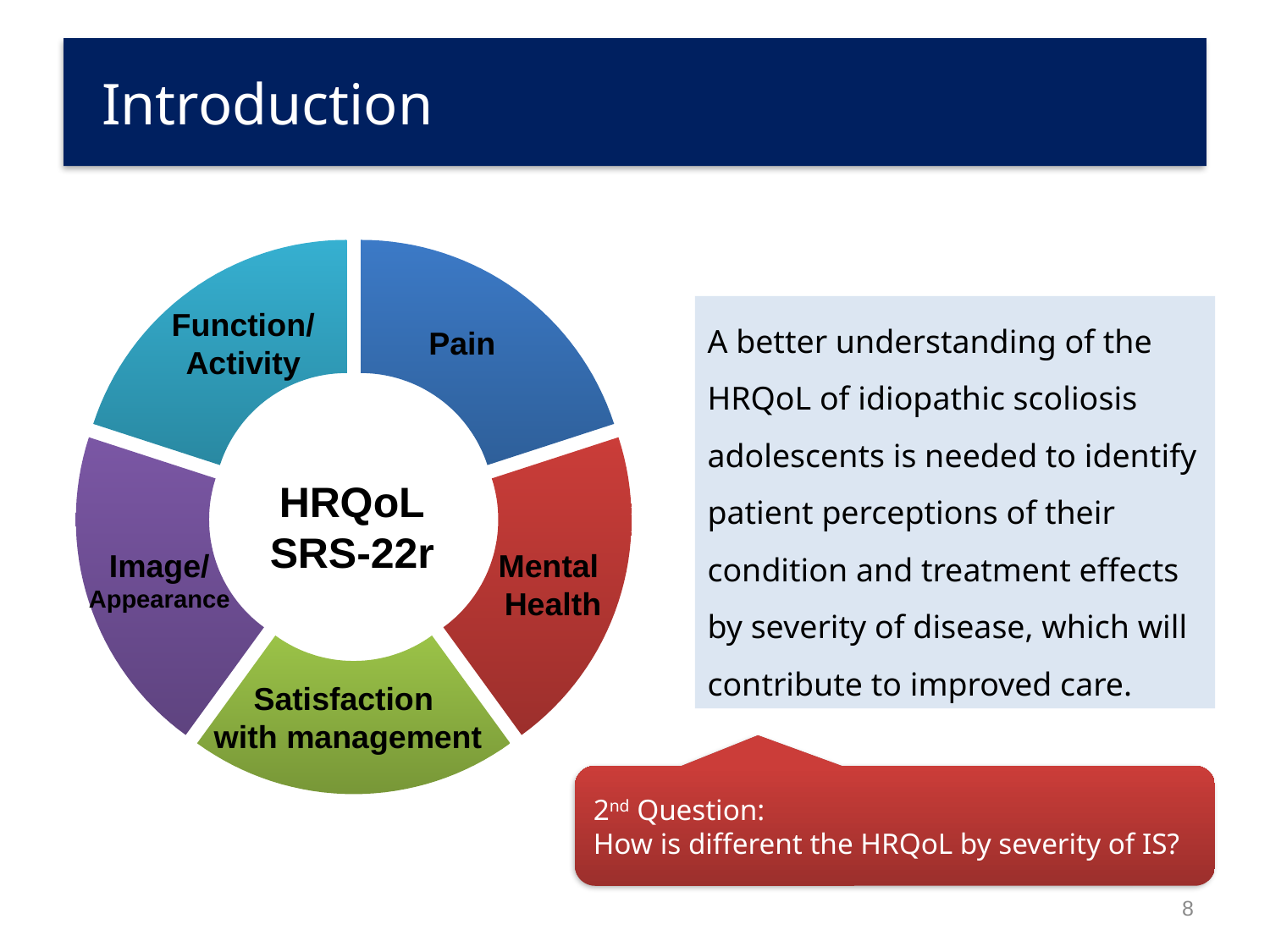
Which segment of the donut chart is labelled 'Pain'? The blue segment at the top right How many segments does the donut chart have? 5 Does the donut chart display any numeric values on its segments? No Which segment of the donut chart is coloured purple? Image/Appearance What kind of chart is shown on the left of the slide? Donut chart Which segment of the donut chart is coloured red? Mental Health Which segment of the donut chart is coloured green? Satisfaction with management What text appears in the centre of the donut chart? HRQoL SRS-22r Which segment of the donut chart is coloured teal? Function/Activity